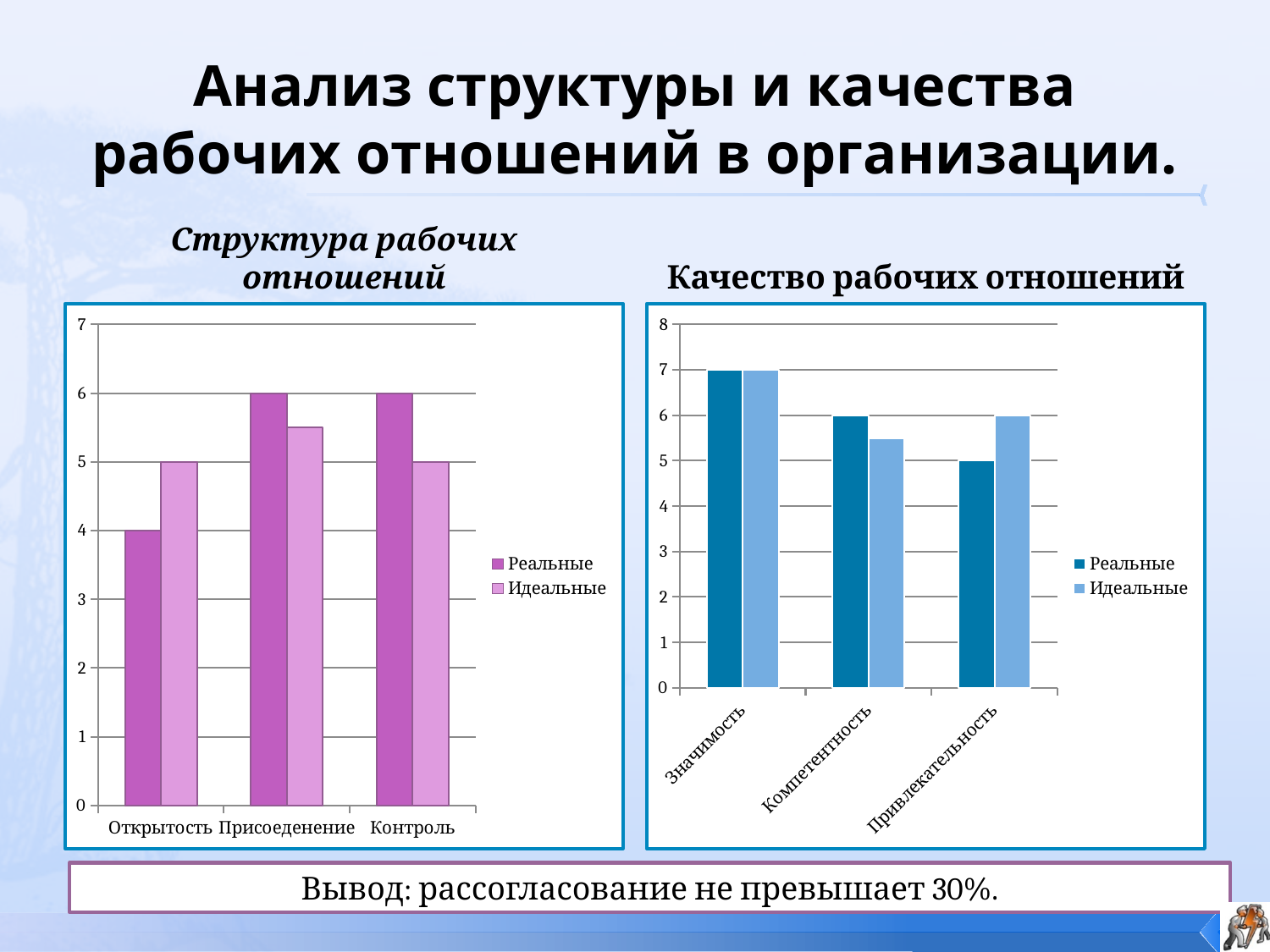
How many categories are shown on the x axis of the "Структура рабочих отношений" chart? 3 In the "Структура рабочих отношений" chart, is the Идеальные value for Присоеденение greater or less than 5? greater In the "Структура рабочих отношений" chart, what is the Идеальные value for Контроль? 5 How many series does the legend of the "Качество рабочих отношений" chart list? 2 In the "Качество рабочих отношений" chart, is the Реальные value for Компетентность larger or smaller than the Идеальные value for Компетентность? larger In the "Качество рабочих отношений" chart, which category has the lowest Реальные value? Привлекательность In the "Качество рабочих отношений" chart, what is the Идеальные value for Привлекательность? 6 What kind of chart is the "Структура рабочих отношений" chart on the left? bar chart In the "Структура рабочих отношений" chart, which category has the lowest Реальные value? Открытость In the "Структура рабочих отношений" chart, what is the Реальные value for Открытость? 4 In the "Качество рабочих отношений" chart, what is the difference between the Идеальные and Реальные values for Привлекательность? 1 In the "Качество рабочих отношений" chart, what is the Реальные value for Значимость? 7